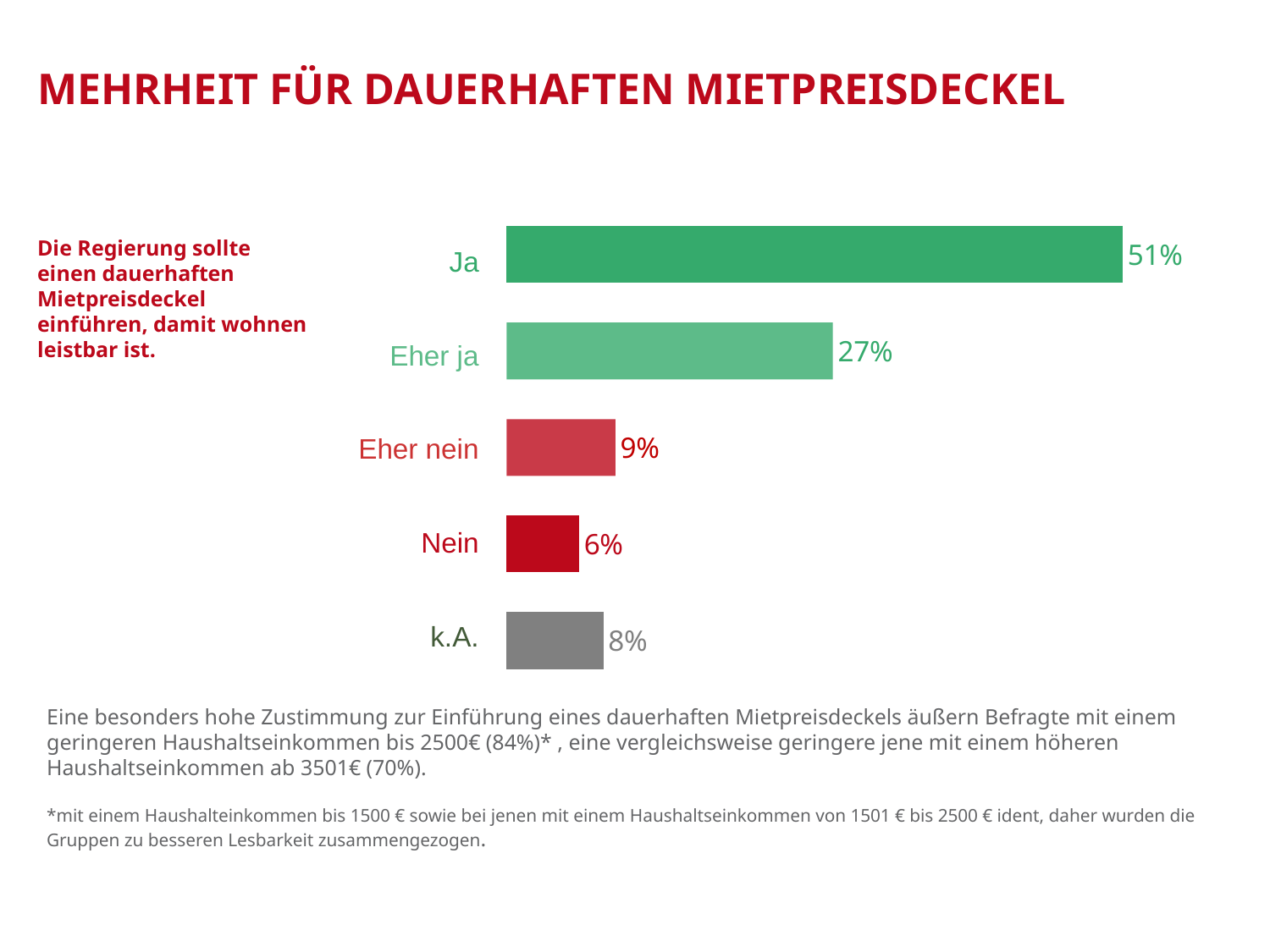
What is the value for "Eher nein"? 9% What kind of chart is shown on the slide? Bar chart Which category has the lowest value? Nein Which is larger, the value for "Eher nein" or the value for "k.A."? Eher nein What is the difference between the values for "Ja" and "Eher ja"? 24% What is the value for "Nein"? 6% What is the value for "k.A."? 8% How many categories are shown in the chart? 5 What is the value for "Eher ja"? 27% What is the value for "Ja"? 51% What is the title of the slide? MEHRHEIT FÜR DAUERHAFTEN MIETPREISDECKEL Which category has the highest value? Ja